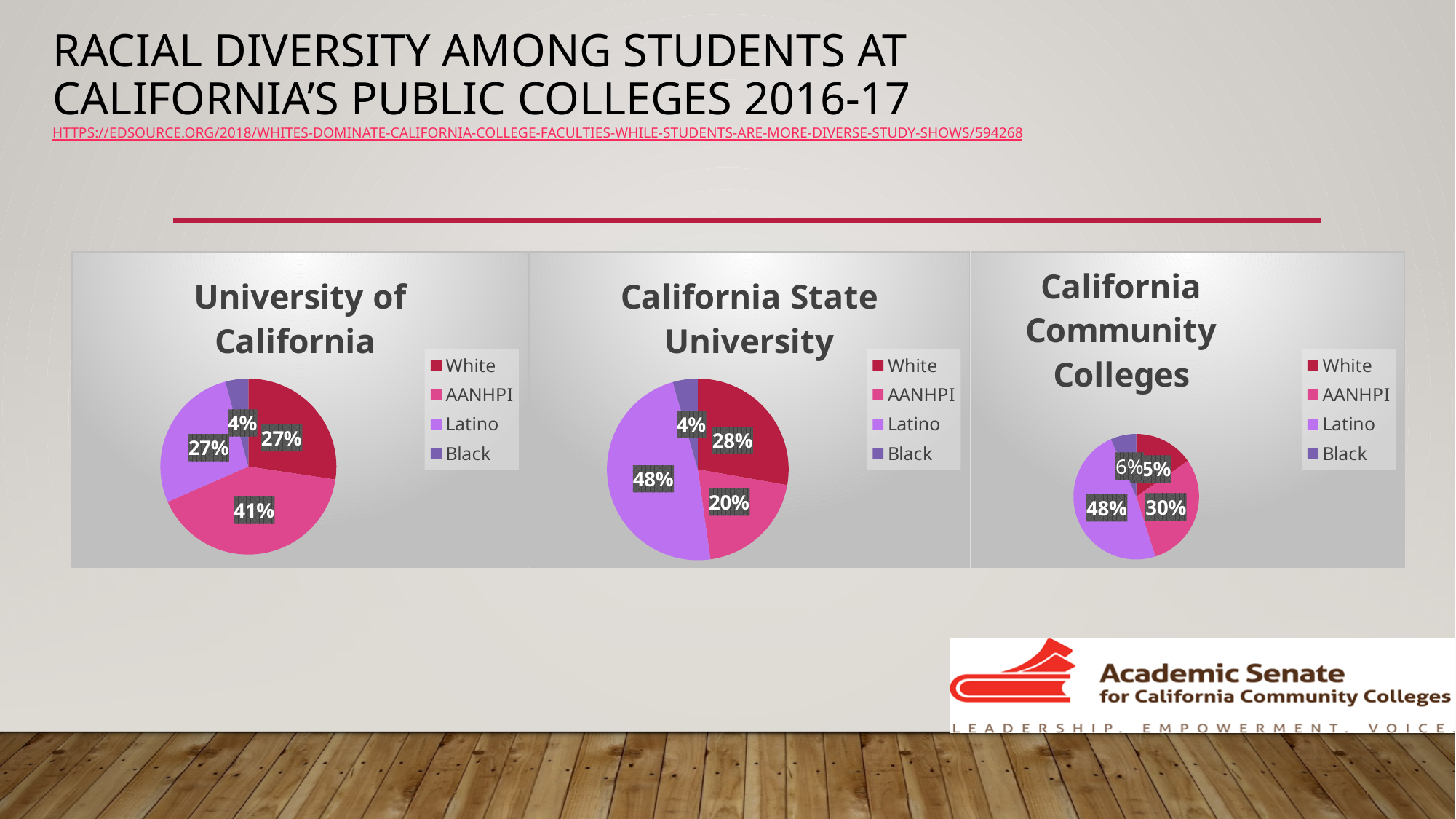
In the California Community Colleges chart, what share of students is AANHPI? 30% What type of chart is used for the University of California data? Pie chart In the University of California chart, which group has the largest share? AANHPI In the University of California chart, what share of students is AANHPI? 41% In the California State University chart, what share of students is Latino? 48% In the California State University chart, what percentage is shown for White students? 28% In the California State University chart, which is larger, the White share or the AANHPI share? White In the University of California chart, what percentage is shown for Black students? 4% In the California Community Colleges chart, which group has the largest share? Latino How many groups does the legend of the California State University chart list? 4 In the California State University chart, what is the difference between the Latino share and the White share? 20% In the California State University chart, which group has the smallest share? Black